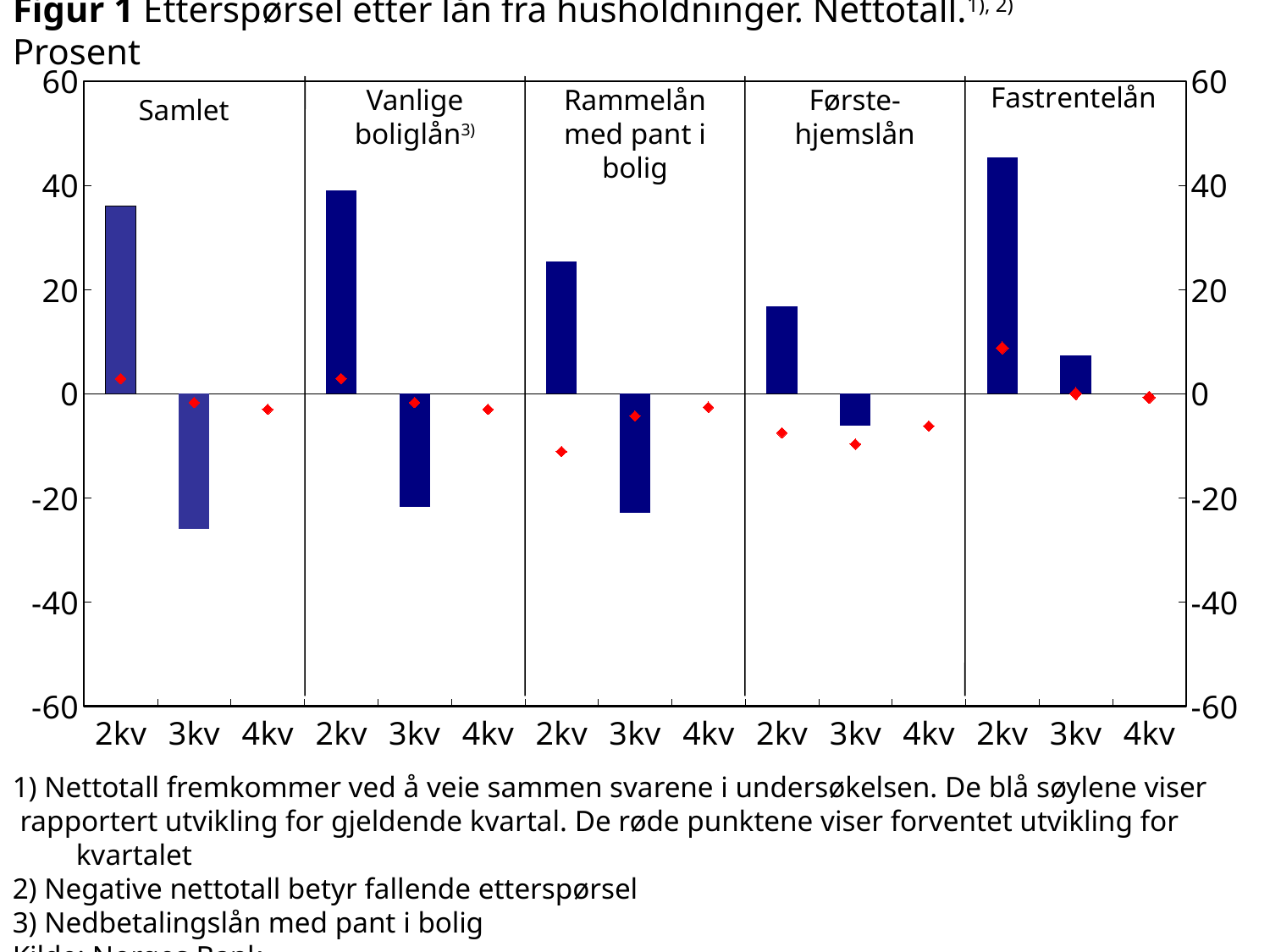
Is the 2kv bar for Fastrentelån greater or less than 40? greater What kind of chart is shown in Figur 1? bar chart Which is larger, the 2kv bar for Vanlige boliglån or the 2kv bar for Rammelån med pant i bolig? Vanlige boliglån Which loan category has the lowest 3kv bar? Samlet Which loan category has the highest 2kv bar? Fastrentelån Is the 2kv bar for Førstehjemslån greater or less than 20? less According to the footnote, what do the red points show? Forventet utvikling for kvartalet Does the bar for Samlet rise or fall from 2kv to 3kv? fall Is the 3kv bar for Samlet greater or less than -20? less How many loan categories (panels) are shown in the chart? 5 Which is larger, the 3kv bar for Fastrentelån or the 3kv bar for Førstehjemslån? Fastrentelån